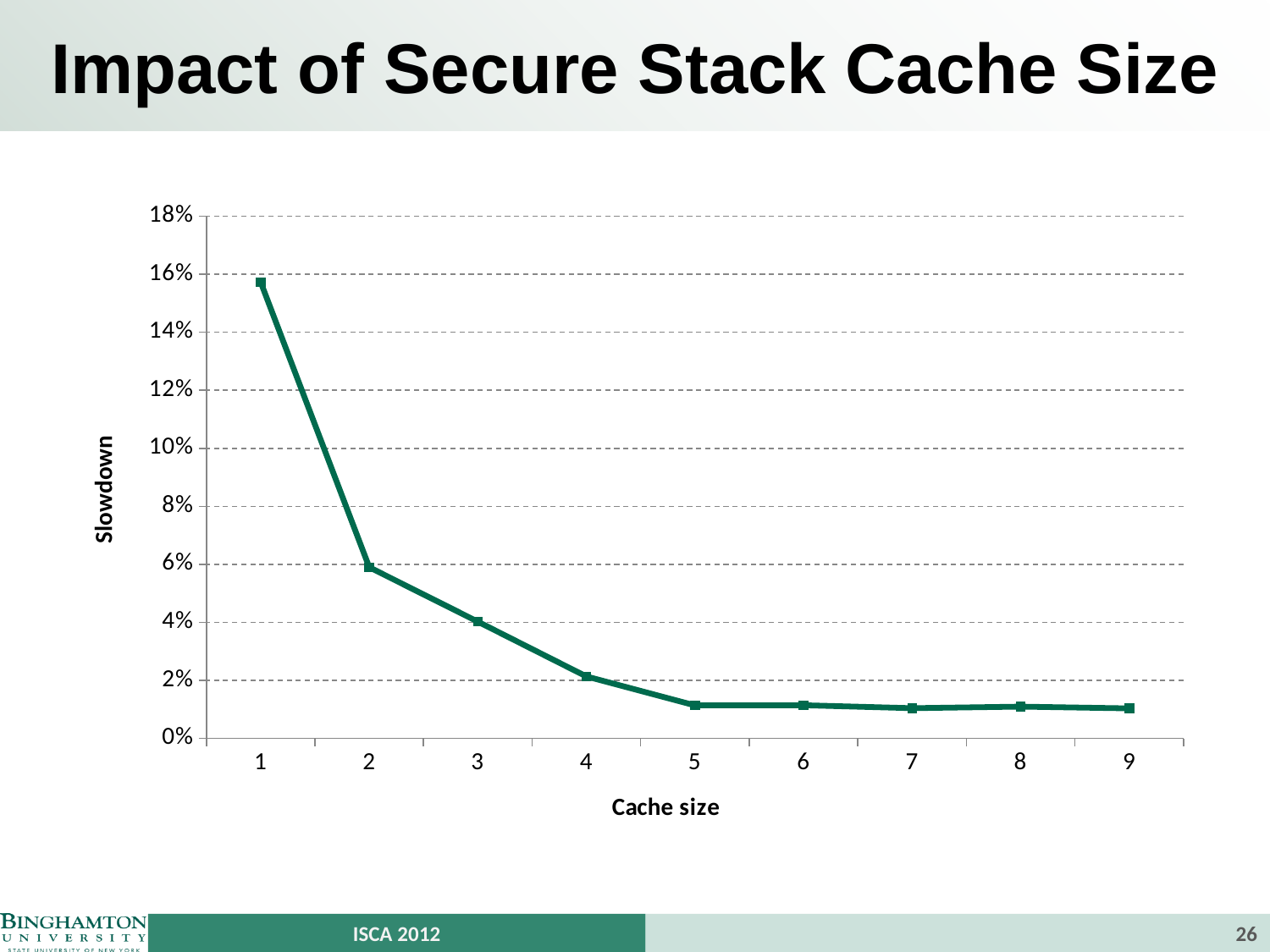
Is the slowdown for cache size 2 greater or less than 8%? less Does the slowdown rise or fall as cache size increases? fall What kind of chart is shown on the slide? line chart Which has a larger slowdown, cache size 1 or cache size 2? cache size 1 Which cache size has the highest slowdown? 1 What is the title of the slide? Impact of Secure Stack Cache Size Is the slowdown for cache size 5 greater or less than 2%? less Is the slowdown for cache size 9 greater or less than 2%? less How many cache sizes are plotted on the x axis? 9 What is the label of the y axis? Slowdown